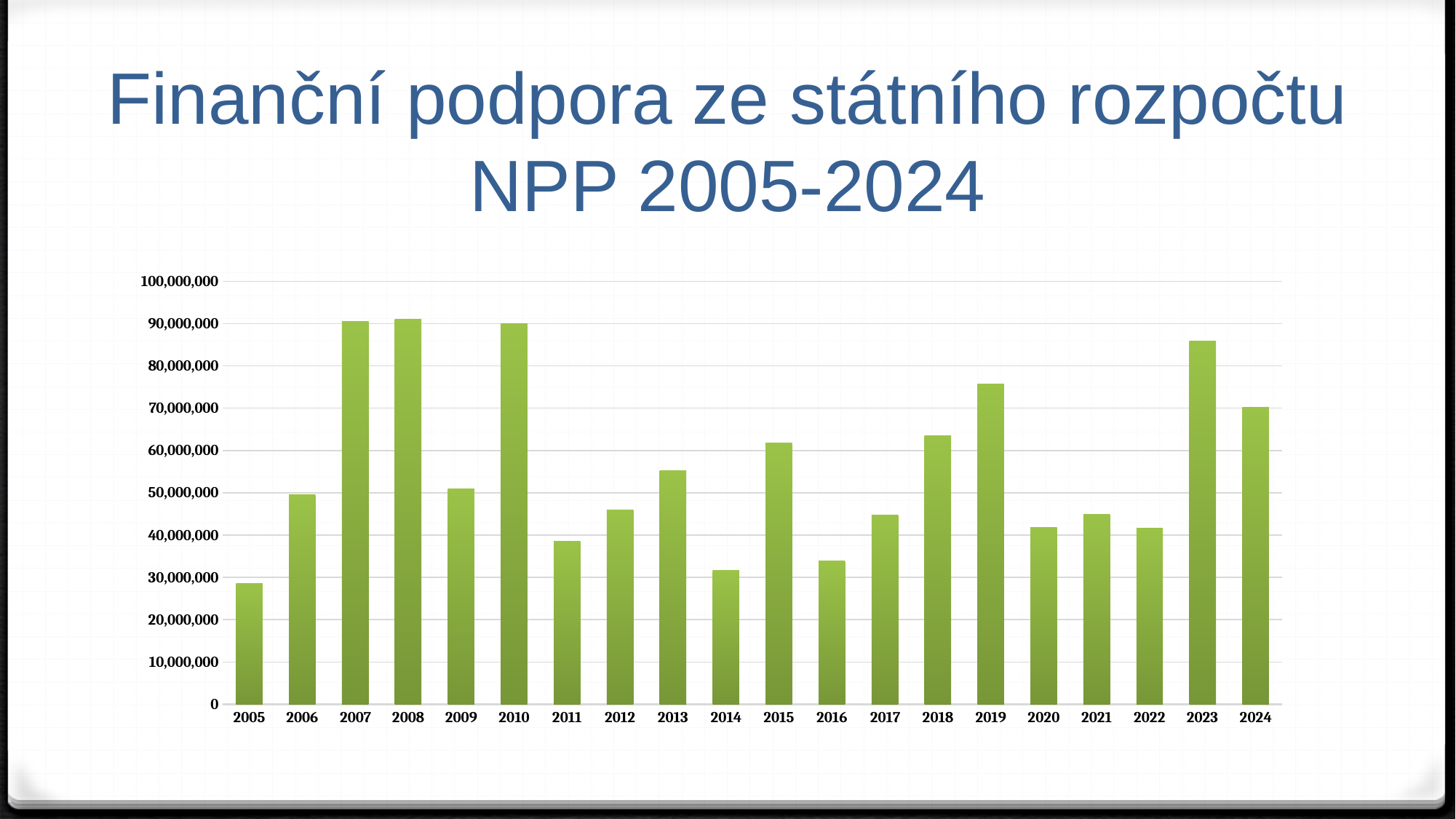
What is the title of the slide containing the chart? Finanční podpora ze státního rozpočtu NPP 2005-2024 Do the values rise or fall from 2011 to 2013? rise Is the value for 2016 greater or less than 40,000,000? less How many years are shown on the x axis of the chart? 20 Which year has the lowest value in the chart? 2005 What kind of chart is shown on the slide? bar chart Which is larger, the value for 2013 or the value for 2015? 2015 Is the value for 2019 greater or less than 70,000,000? greater Is the value for 2023 greater or less than 80,000,000? greater Which is larger, the value for 2019 or the value for 2024? 2019